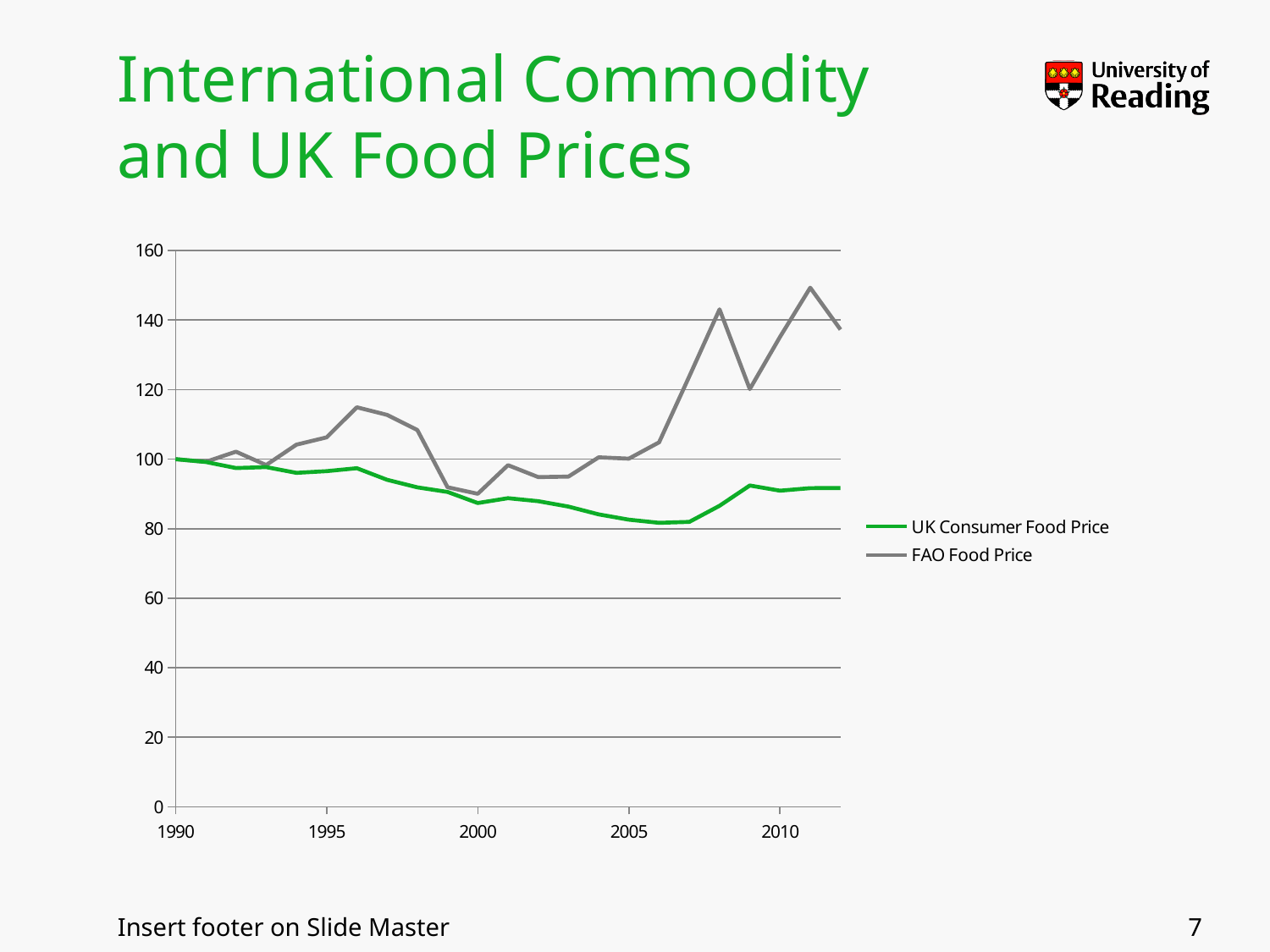
Is the UK Consumer Food Price value in 2000 greater or less than 100? less In which year does the FAO Food Price series reach its highest value? 2011 Is the FAO Food Price value in 1996 greater or less than 100? greater Does the UK Consumer Food Price series rise or fall between 1996 and 2006? fall What is the value of both series in 1990? 100 Does the FAO Food Price series rise or fall between 2009 and 2011? rise Is the FAO Food Price value in 2011 greater or less than 140? greater What kind of chart is shown on the slide? line chart What is the title of the slide containing the chart? International Commodity and UK Food Prices Which series has the larger value in 2011, UK Consumer Food Price or FAO Food Price? FAO Food Price Which colour is used for the UK Consumer Food Price line? green How many series does the legend list? 2